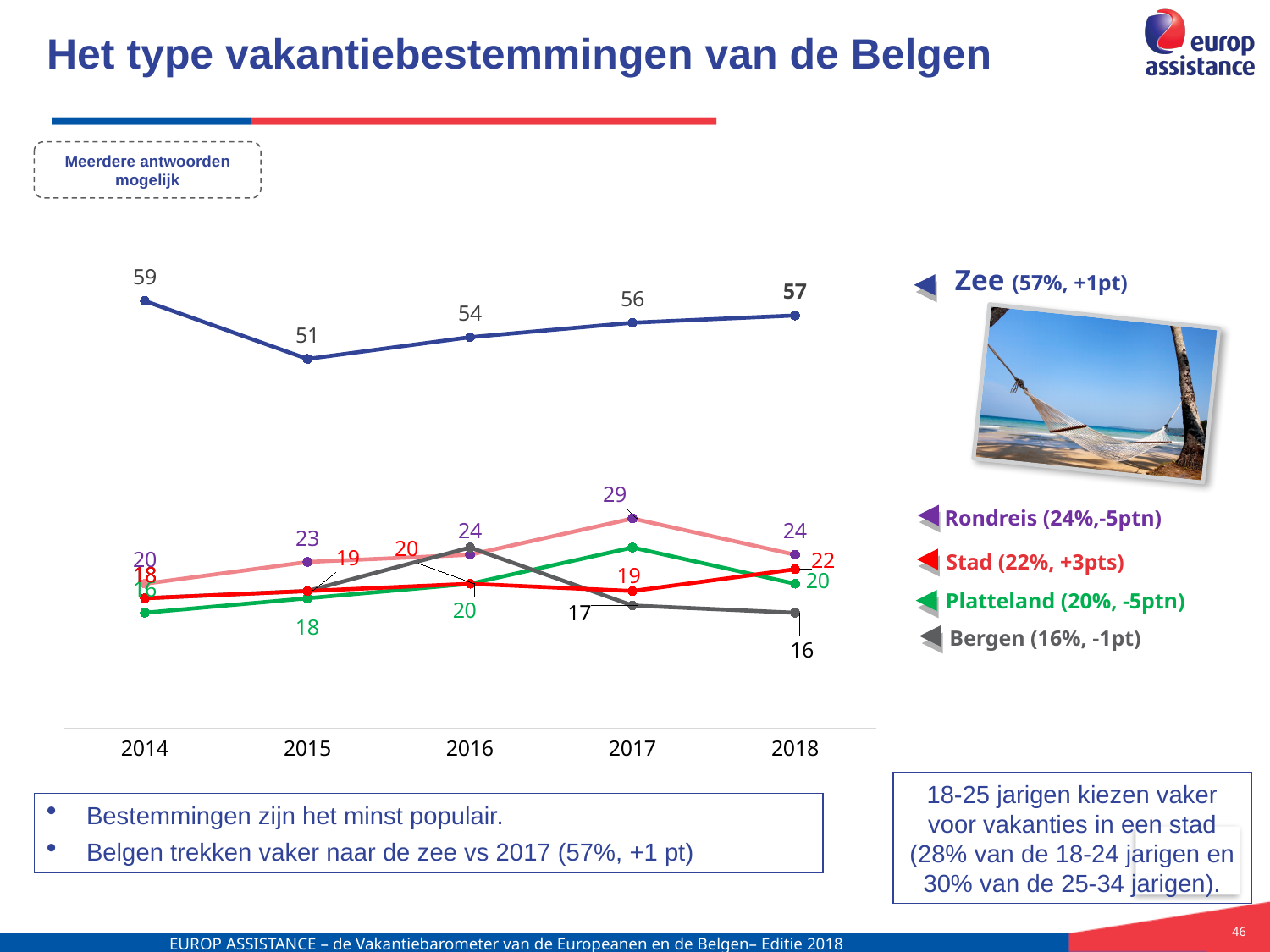
In which year is the Zee line at its lowest? 2015 In which year is the Zee line at its highest? 2014 How many years are shown on the x axis? 5 What type of chart is shown on the slide? line chart What is the value for Zee in 2015? 51 What is the value for Bergen in 2018? 16 What is the difference between the Zee values in 2014 and 2015? 8 How many destination types (series) are listed to the right of the chart? 5 Which is larger in 2018, the value for Rondreis or the value for Platteland? Rondreis What is the value for Stad in 2018? 22 What is the value for Zee in 2018? 57 What is the value for Rondreis in 2017? 29